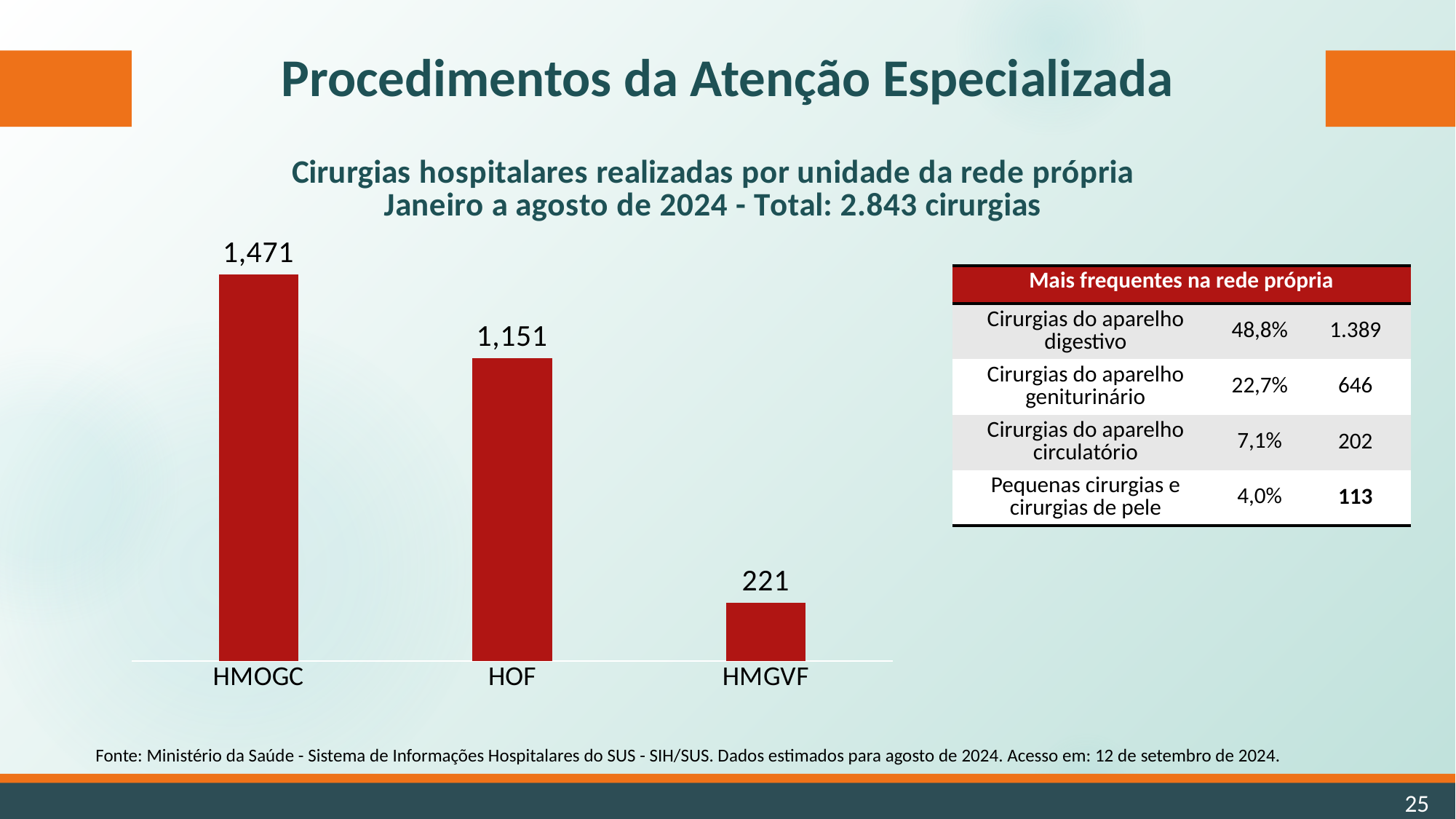
Do the values rise or fall from left to right across the x axis? fall What is the value for HMGVF? 221 What is the difference between the values for HOF and HMGVF? 930 How many units are shown in the chart? 3 What kind of chart is shown on the slide? bar chart What is the value for HOF? 1,151 What is the difference between the values for HMOGC and HOF? 320 What is the value for HMOGC? 1,471 Which unit has the highest number of surgeries? HMOGC Which is larger, the value for HOF or the value for HMGVF? HOF What colour are the bars in the chart? red Which unit has the lowest number of surgeries? HMGVF